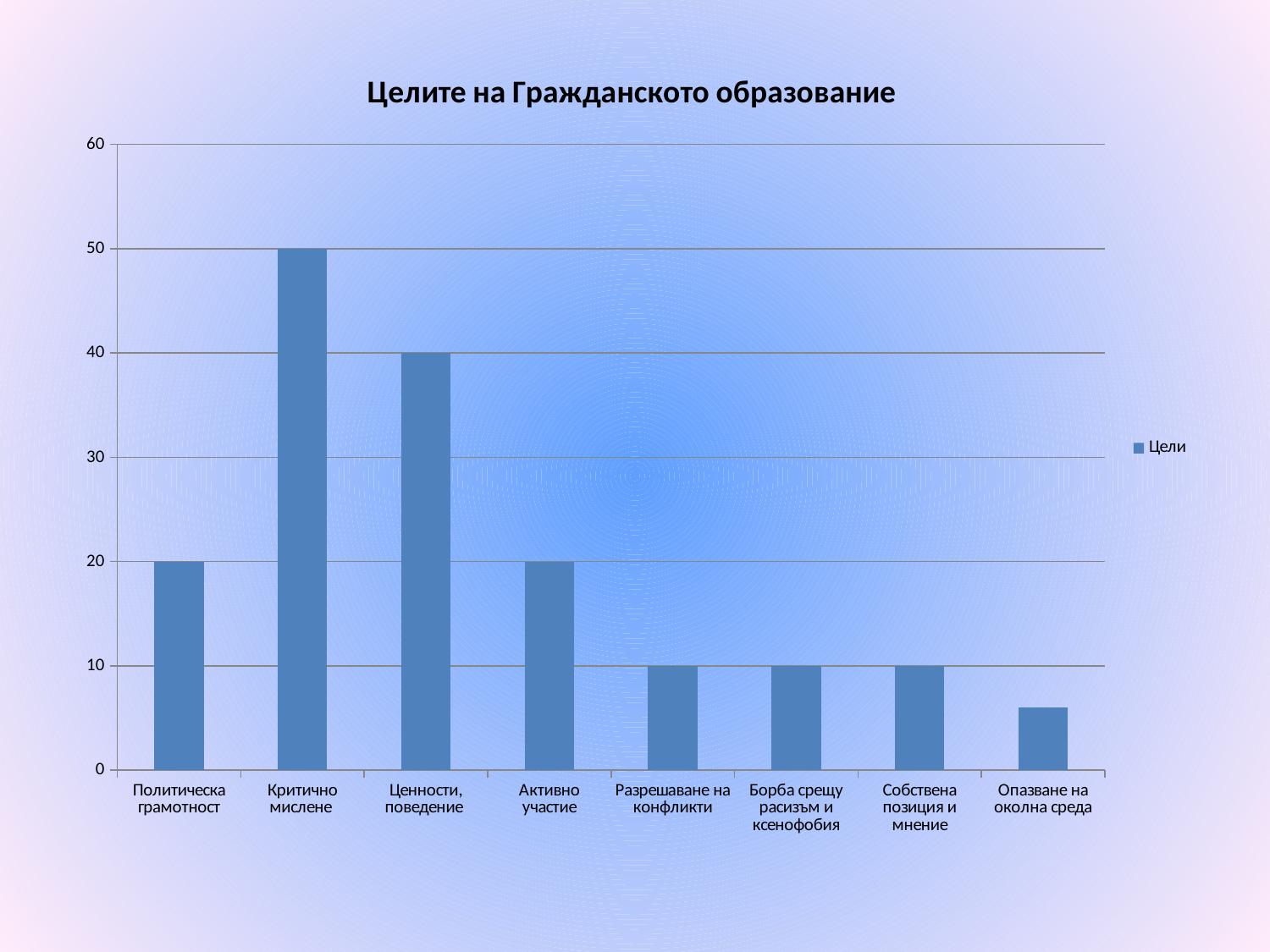
How many categories are shown on the x axis? 8 What is the value for Критично мислене? 50 Which is larger, the value for Активно участие or the value for Собствена позиция и мнение? Активно участие How many series does the legend list? 1 What kind of chart is shown on the slide? bar chart What is the value for Ценности, поведение? 40 Which category has the lowest value? Опазване на околна среда Which category has the highest value? Критично мислене Is the value for Опазване на околна среда greater or less than 10? less What is the value for Разрешаване на конфликти? 10 What is the value for Политическа грамотност? 20 What is the difference between the values for Критично мислене and Ценности, поведение? 10